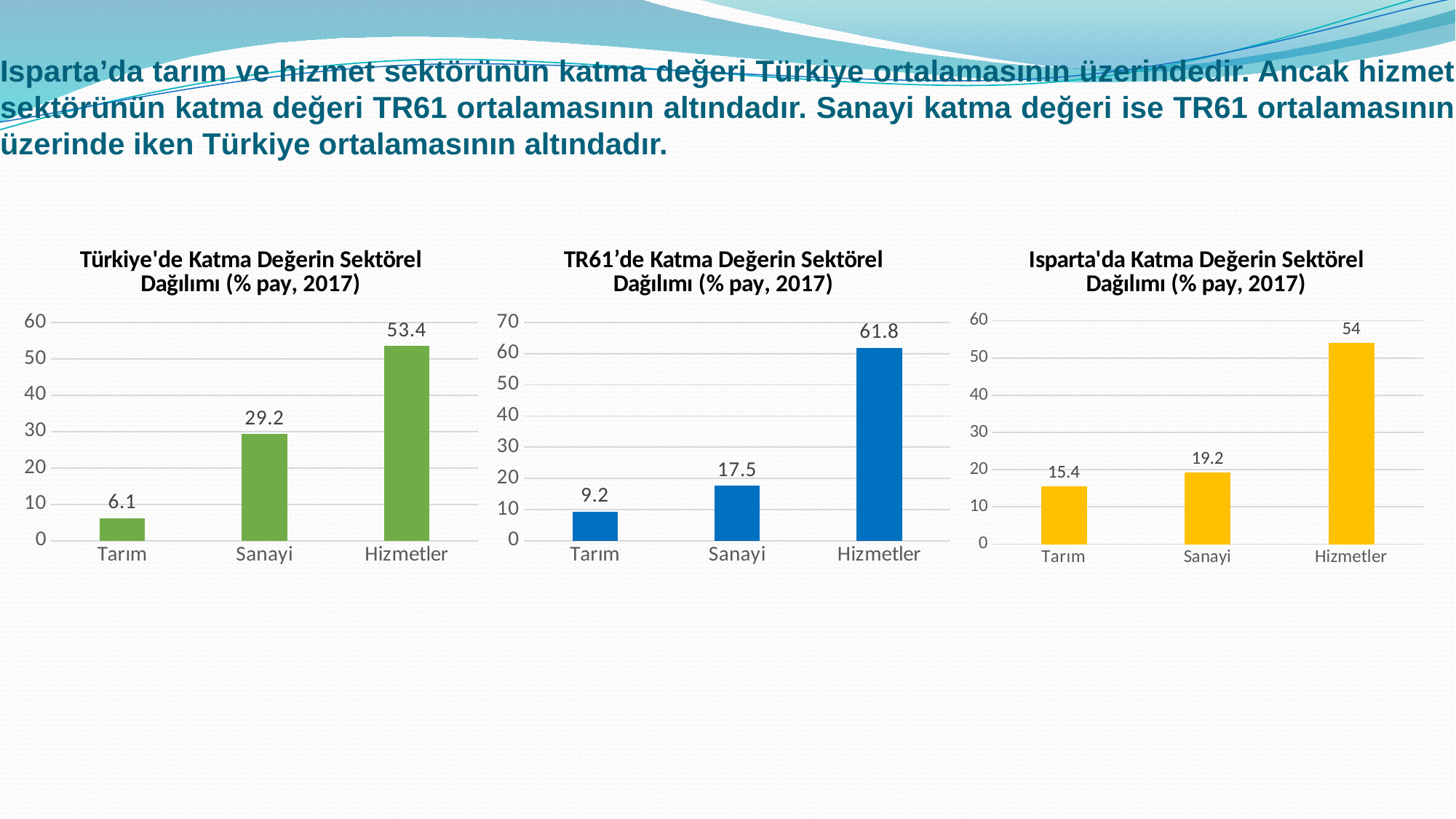
What kind of chart is the chart titled "Isparta'da Katma Değerin Sektörel Dağılımı (% pay, 2017)"? Bar chart In the chart titled "Türkiye'de Katma Değerin Sektörel Dağılımı (% pay, 2017)", what is the value for Sanayi? 29.2 What colour are the bars in the chart titled "TR61'de Katma Değerin Sektörel Dağılımı (% pay, 2017)"? Blue In the chart titled "TR61'de Katma Değerin Sektörel Dağılımı (% pay, 2017)", what is the value for Hizmetler? 61.8 In the chart titled "Türkiye'de Katma Değerin Sektörel Dağılımı (% pay, 2017)", which category has the lowest value? Tarım In the chart titled "Isparta'da Katma Değerin Sektörel Dağılımı (% pay, 2017)", which category has the highest value? Hizmetler In the chart titled "Türkiye'de Katma Değerin Sektörel Dağılımı (% pay, 2017)", do the values rise or fall from Tarım to Hizmetler? Rise In the chart titled "Isparta'da Katma Değerin Sektörel Dağılımı (% pay, 2017)", which is larger, the value for Sanayi or the value for Tarım? Sanayi How many categories are shown in the chart titled "TR61'de Katma Değerin Sektörel Dağılımı (% pay, 2017)"? 3 In the chart titled "TR61'de Katma Değerin Sektörel Dağılımı (% pay, 2017)", what is the difference between the values for Hizmetler and Sanayi? 44.3 In the chart titled "Isparta'da Katma Değerin Sektörel Dağılımı (% pay, 2017)", what is the value for Tarım? 15.4 In the chart titled "Türkiye'de Katma Değerin Sektörel Dağılımı (% pay, 2017)", is the value for Hizmetler greater or less than 50? greater